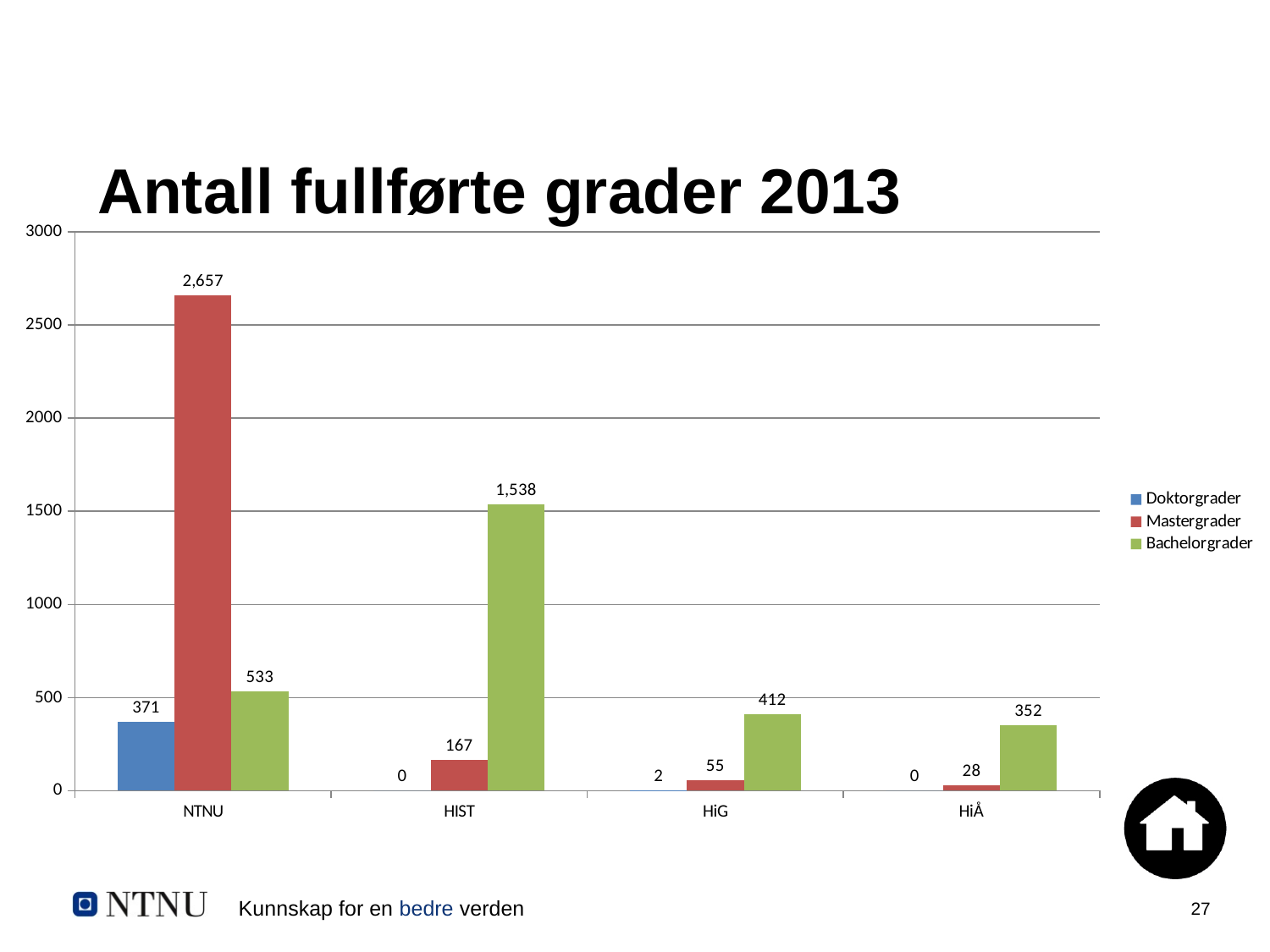
What is the title of the chart? Antall fullførte grader 2013 What kind of chart is shown on the slide? Bar chart What is the value for Bachelorgrader at HIST? 1,538 What is the value for Doktorgrader at HiG? 2 How many series does the legend list? 3 What is the value for Mastergrader at NTNU? 2,657 Which institution has the lowest value for Mastergrader? HiÅ Which is larger: Mastergrader at HIST or Mastergrader at HiG? Mastergrader at HIST How many institutions are shown on the x axis? 4 Which institution has the highest value for Bachelorgrader? HIST What is the value for Mastergrader at HiÅ? 28 What is the difference between Bachelorgrader at NTNU and Bachelorgrader at HiG? 121